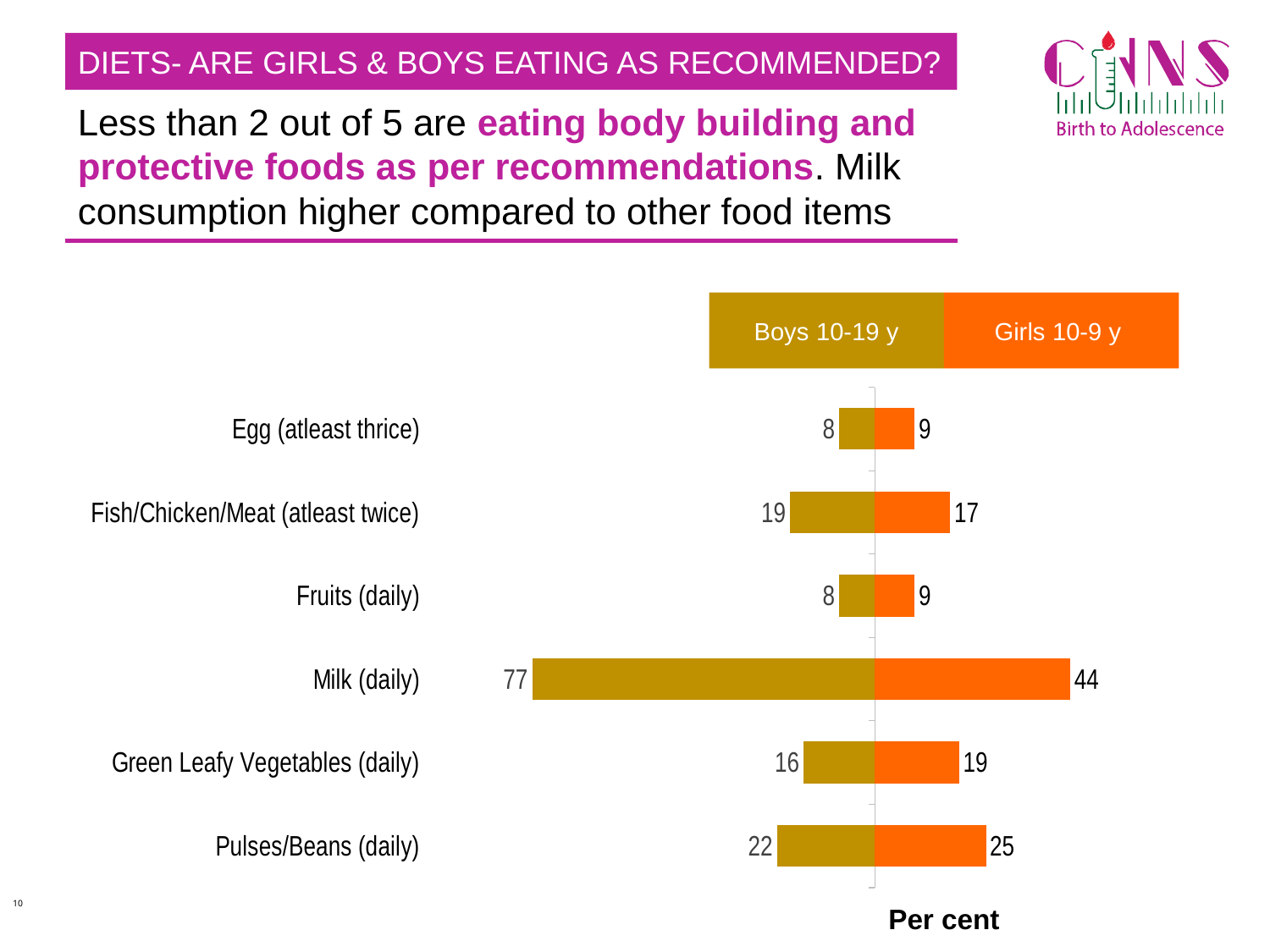
What is the value for Boys 10-19 y for Milk (daily)? 77 What unit is labelled on the chart's axis? Per cent What kind of chart is shown on the slide? Bar chart How many food item categories are shown in the chart? 6 What is the value for Girls 10-9 y for Fish/Chicken/Meat (atleast twice)? 17 Which food item has the highest value for Boys 10-19 y? Milk (daily) How many series does the legend list? 2 What is the difference between the Boys 10-19 y and Girls 10-9 y values for Milk (daily)? 33 Which food item has the lowest value for Girls 10-9 y? Egg (atleast thrice) and Fruits (daily) What is the value for Girls 10-9 y for Pulses/Beans (daily)? 25 What is the difference between the Girls 10-9 y and Boys 10-19 y values for Pulses/Beans (daily)? 3 For Green Leafy Vegetables (daily), which is larger: the value for Boys 10-19 y or Girls 10-9 y? Girls 10-9 y